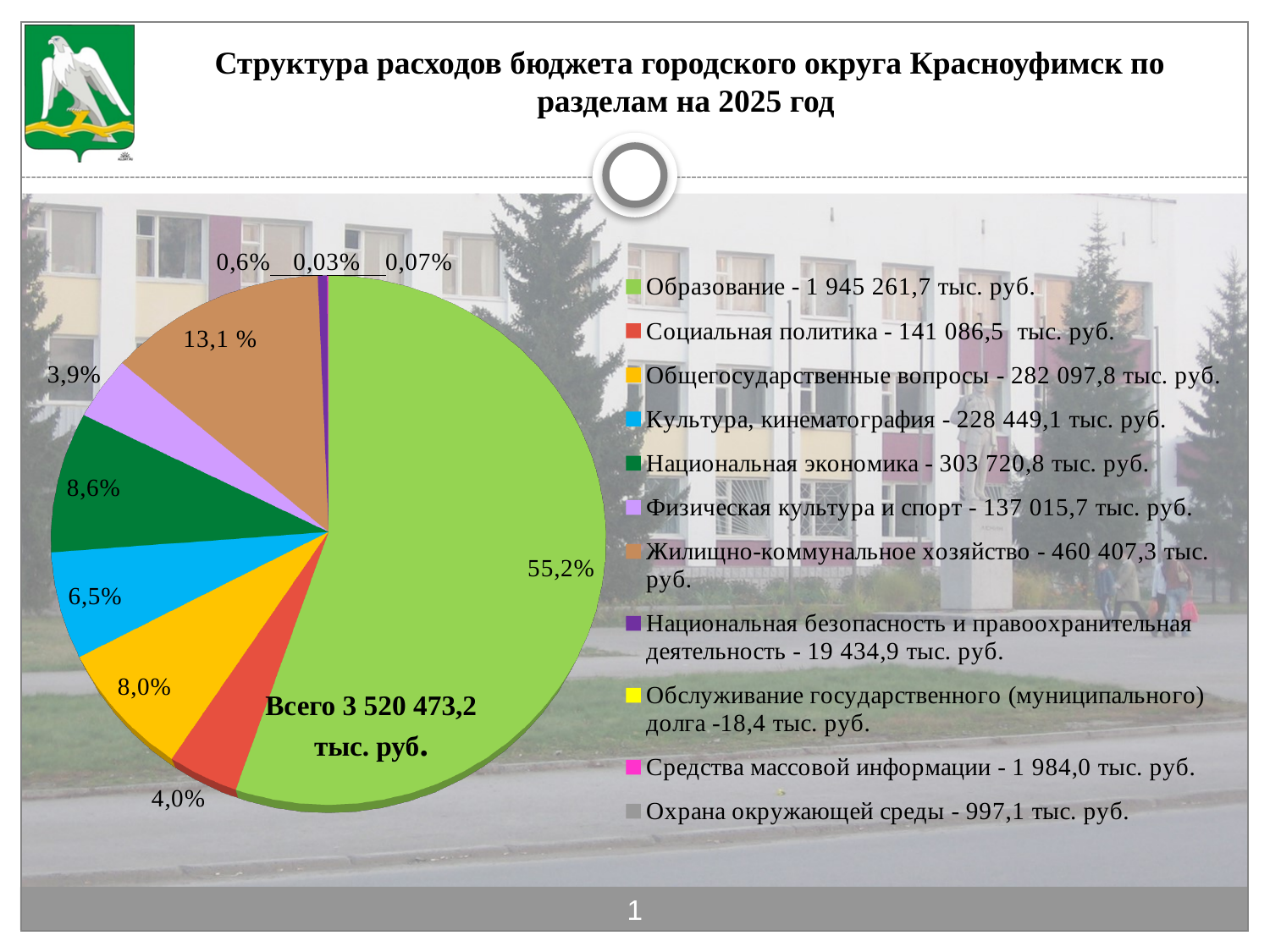
Which is larger: Национальная экономика or Общегосударственные вопросы? Национальная экономика What total amount is printed on the pie chart? Всего 3 520 473,2 тыс. руб. What share of the pie does Образование take? 55,2% What share of the pie does Национальная экономика take? 8,6% What share of the pie does Жилищно-коммунальное хозяйство take? 13,1 % How many categories does the legend list? 11 Which category has the smallest value in the legend? Обслуживание государственного (муниципального) долга What type of chart is shown on the slide? pie chart What is the difference between the values for Национальная экономика and Общегосударственные вопросы? 21 623,0 тыс. руб. What is the value for Культура, кинематография according to the legend? 228 449,1 тыс. руб. Which category has the largest slice of the pie? Образование What is the value for Социальная политика according to the legend? 141 086,5 тыс. руб.